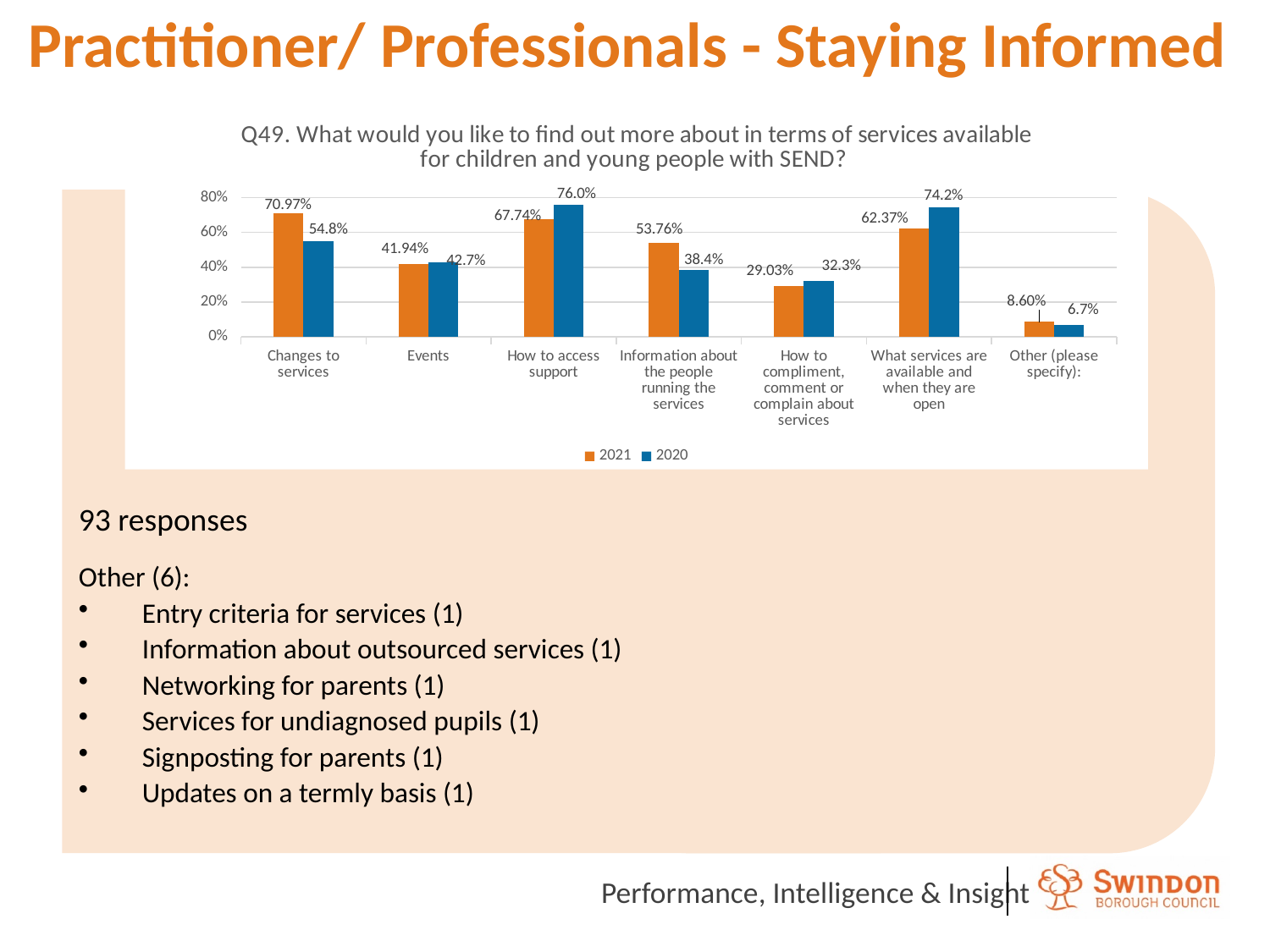
What is the 2020 value for "Other (please specify):"? 6.7% Is the 2021 value for "How to compliment, comment or complain about services" greater or less than 40%? less What is the 2021 value for "Changes to services"? 70.97% Which category has the lowest 2020 value? Other (please specify): How many series does the legend list? 2 What is the 2020 value for "How to access support"? 76.0% Which category has the highest 2021 value? Changes to services What is the 2021 value for "What services are available and when they are open"? 62.37% What kind of chart is shown on the slide? Bar chart What is the difference between the 2021 and 2020 values for "Changes to services"? 16.17 percentage points How many categories are shown on the x axis? 7 For "Information about the people running the services", which year has the larger value, 2021 or 2020? 2021